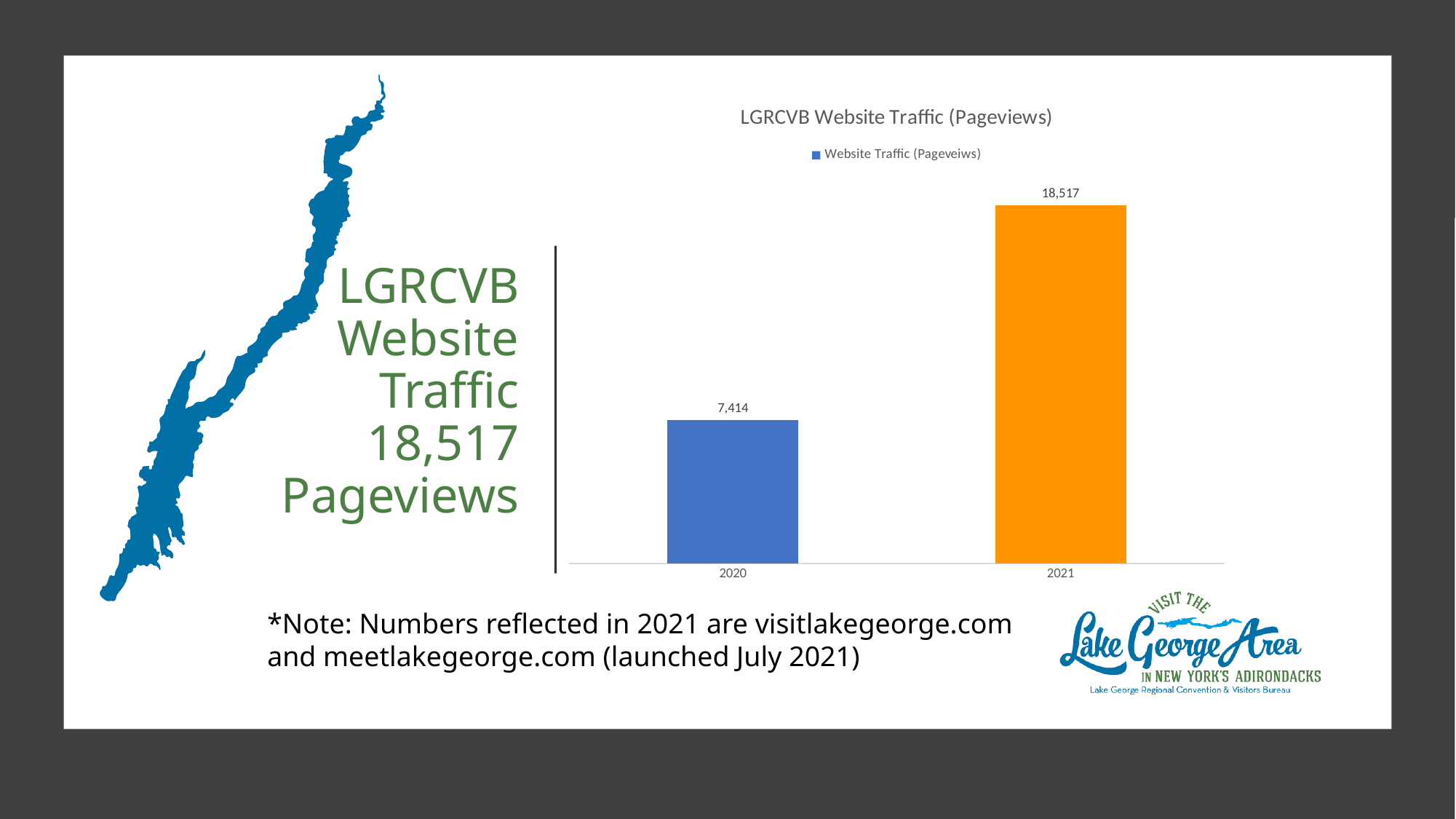
How many years are shown on the chart? 2 Which year has more pageviews, 2020 or 2021? 2021 What is the difference in pageviews between 2021 and 2020? 11,103 What colour is the bar for 2021? Orange Do the pageviews rise or fall from 2020 to 2021? Rise What is the website traffic (pageviews) value for 2021? 18,517 How many series does the legend list? 1 Which year has the highest website traffic? 2021 What is the title of the chart? LGRCVB Website Traffic (Pageviews) What kind of chart is shown on the slide? Bar chart What is the website traffic (pageviews) value for 2020? 7,414 Which year has the lowest website traffic? 2020